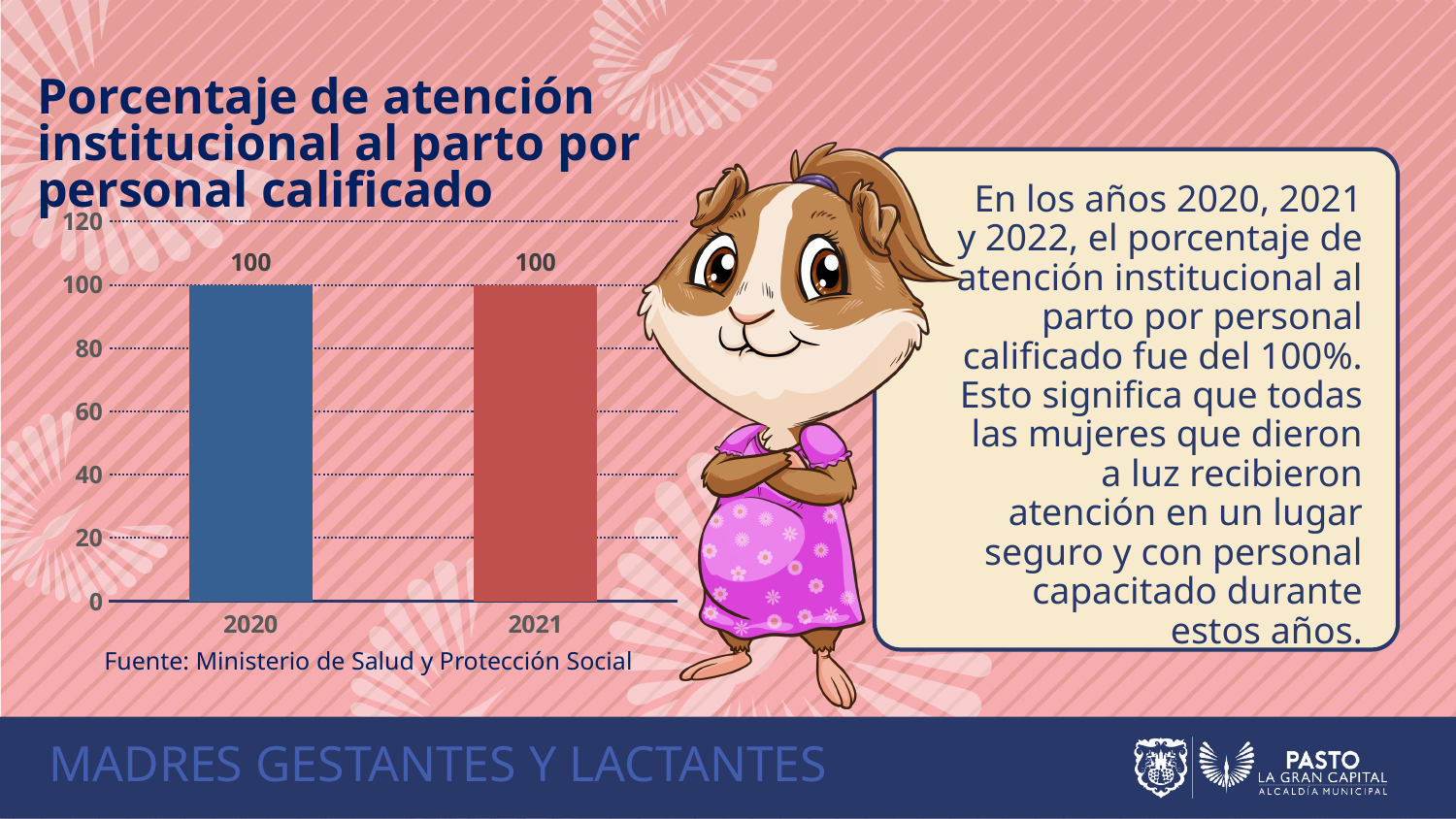
What is the value for 2021 in the chart? 100 What is the highest tick value shown on the vertical axis? 120 What is the title of the chart? Porcentaje de atención institucional al parto por personal calificado Is the value for 2020 greater or less than 80? greater Do the values rise, fall or stay the same from 2020 to 2021? stay the same What kind of chart is shown on the slide? bar chart Is the value for 2021 greater or less than 60? greater What is the value for 2020 in the chart? 100 What is the difference between the values for 2020 and 2021? 0